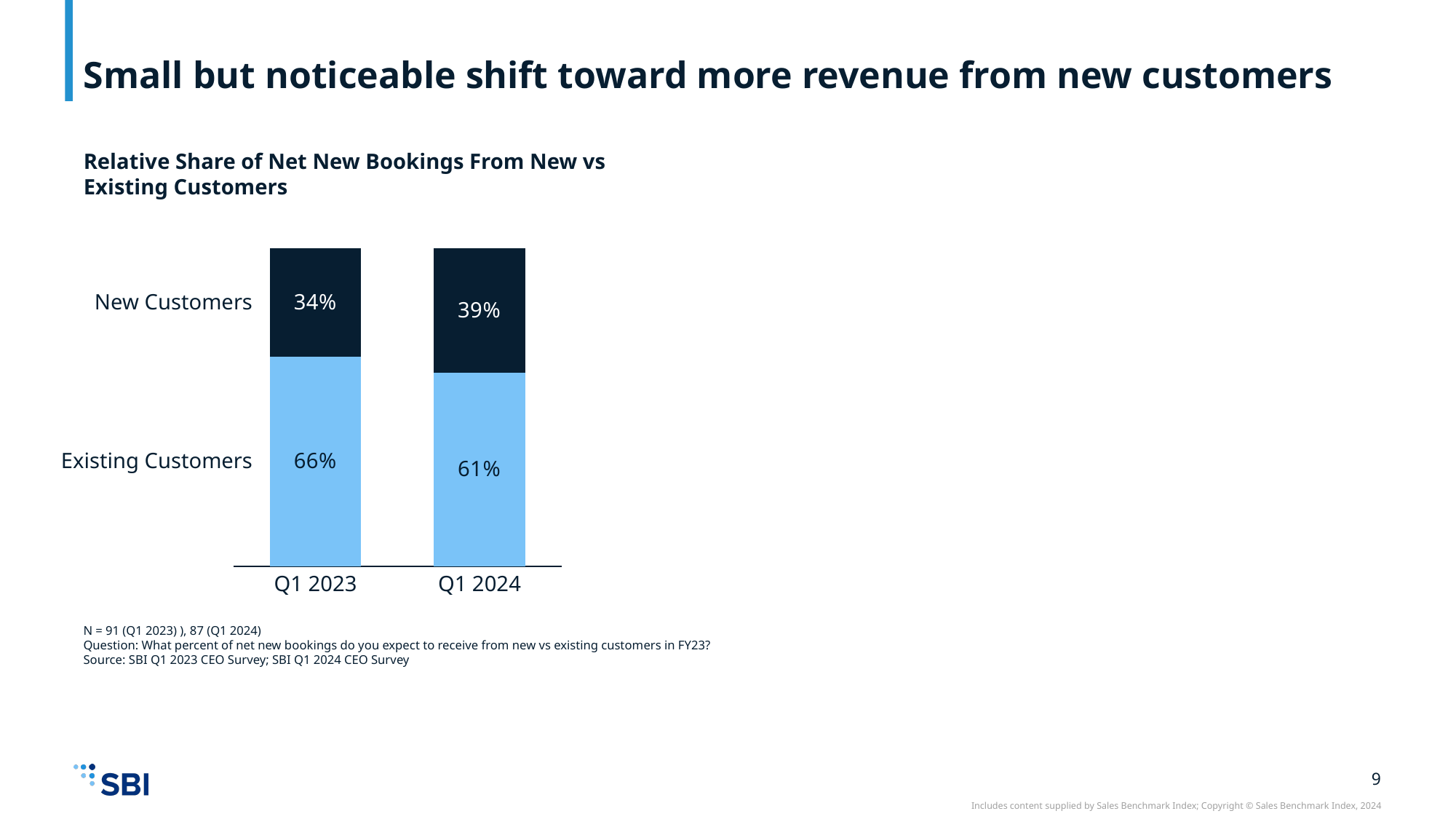
What share of net new bookings came from New Customers in Q1 2024? 39% What share of net new bookings came from Existing Customers in Q1 2024? 61% Which period has the higher share for New Customers? Q1 2024 Which period has the larger share for Existing Customers, Q1 2023 or Q1 2024? Q1 2023 Does the share of net new bookings from New Customers rise or fall from Q1 2023 to Q1 2024? Rise What share of net new bookings came from Existing Customers in Q1 2023? 66% What is the title of the chart? Relative Share of Net New Bookings From New vs Existing Customers What share of net new bookings came from New Customers in Q1 2023? 34% How many periods are shown on the x axis of the chart? 2 What kind of chart is shown on the slide? Stacked bar chart By how many percentage points did the New Customers share change from Q1 2023 to Q1 2024? 5 percentage points How many series (customer segments) does the chart show? 2